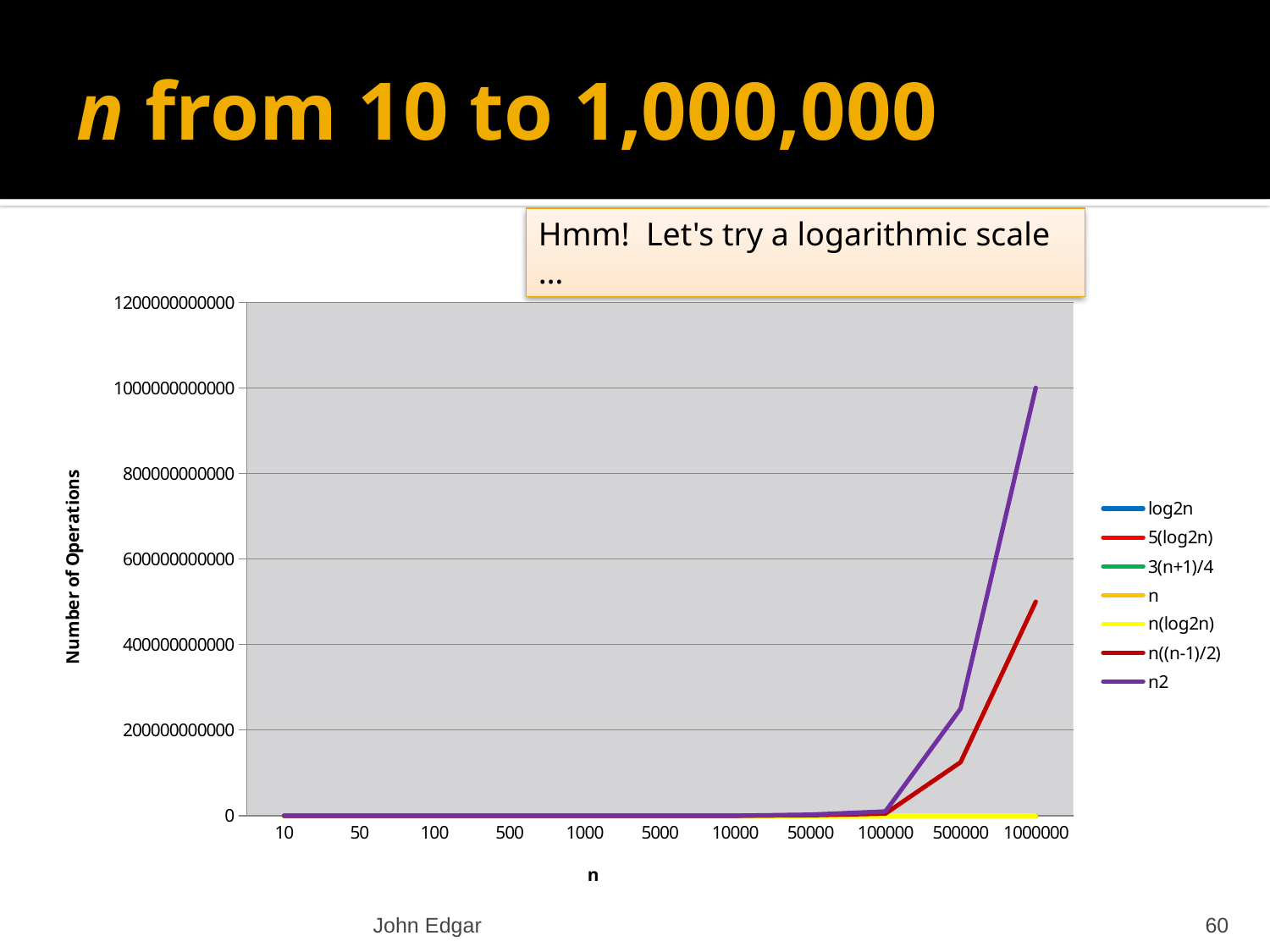
How many series does the legend list? 7 Is the value of n((n-1)/2) at n = 1000000 greater or less than 600000000000? less What is the title of the y axis? Number of Operations How many values of n are shown along the x axis? 11 At n = 1000000, which is larger: n2 or n((n-1)/2)? n2 Is the value of n2 at n = 500000 greater or less than 400000000000? less Is the value of n((n-1)/2) at n = 500000 greater or less than 200000000000? less Which series has the highest value at n = 1000000? n2 What kind of chart is shown on the slide? line chart What is the value of the n2 series at n = 1000000? 1000000000000 Does the n2 series rise or fall as n increases along the x axis? rise